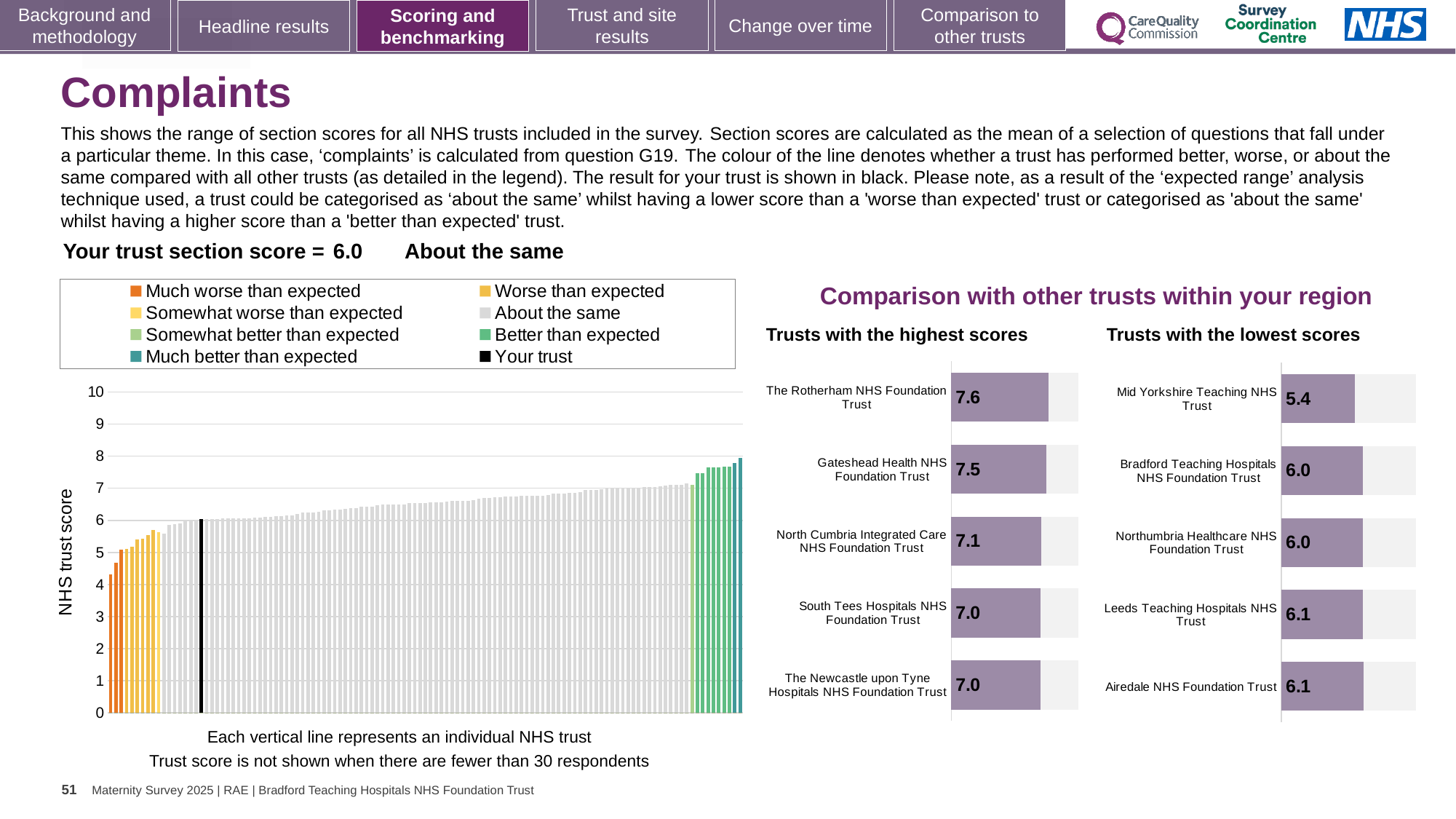
In the 'Trusts with the highest scores' chart, how many trusts are shown? 5 In the NHS trust score chart on the left, is the value of the leftmost bar greater or less than 5? less In the 'Trusts with the highest scores' chart, what is the score for The Rotherham NHS Foundation Trust? 7.6 In the 'Trusts with the lowest scores' chart, which trust has the lowest score? Mid Yorkshire Teaching NHS Trust In the 'Trusts with the highest scores' chart, which trust has the highest score? The Rotherham NHS Foundation Trust In the NHS trust score chart on the left, what is the section score for your trust? 6.0 In the NHS trust score chart on the left, do the bar values rise or fall from left to right? rise In the 'Trusts with the lowest scores' chart, which has the larger score: Mid Yorkshire Teaching NHS Trust or Leeds Teaching Hospitals NHS Trust? Leeds Teaching Hospitals NHS Trust In the 'Trusts with the highest scores' chart, what is the difference between the scores of The Rotherham NHS Foundation Trust and South Tees Hospitals NHS Foundation Trust? 0.6 How many entries does the legend of the NHS trust score chart on the left list? 8 In the 'Trusts with the lowest scores' chart, what is the score for Airedale NHS Foundation Trust? 6.1 In the 'Trusts with the lowest scores' chart, what is the score for Mid Yorkshire Teaching NHS Trust? 5.4